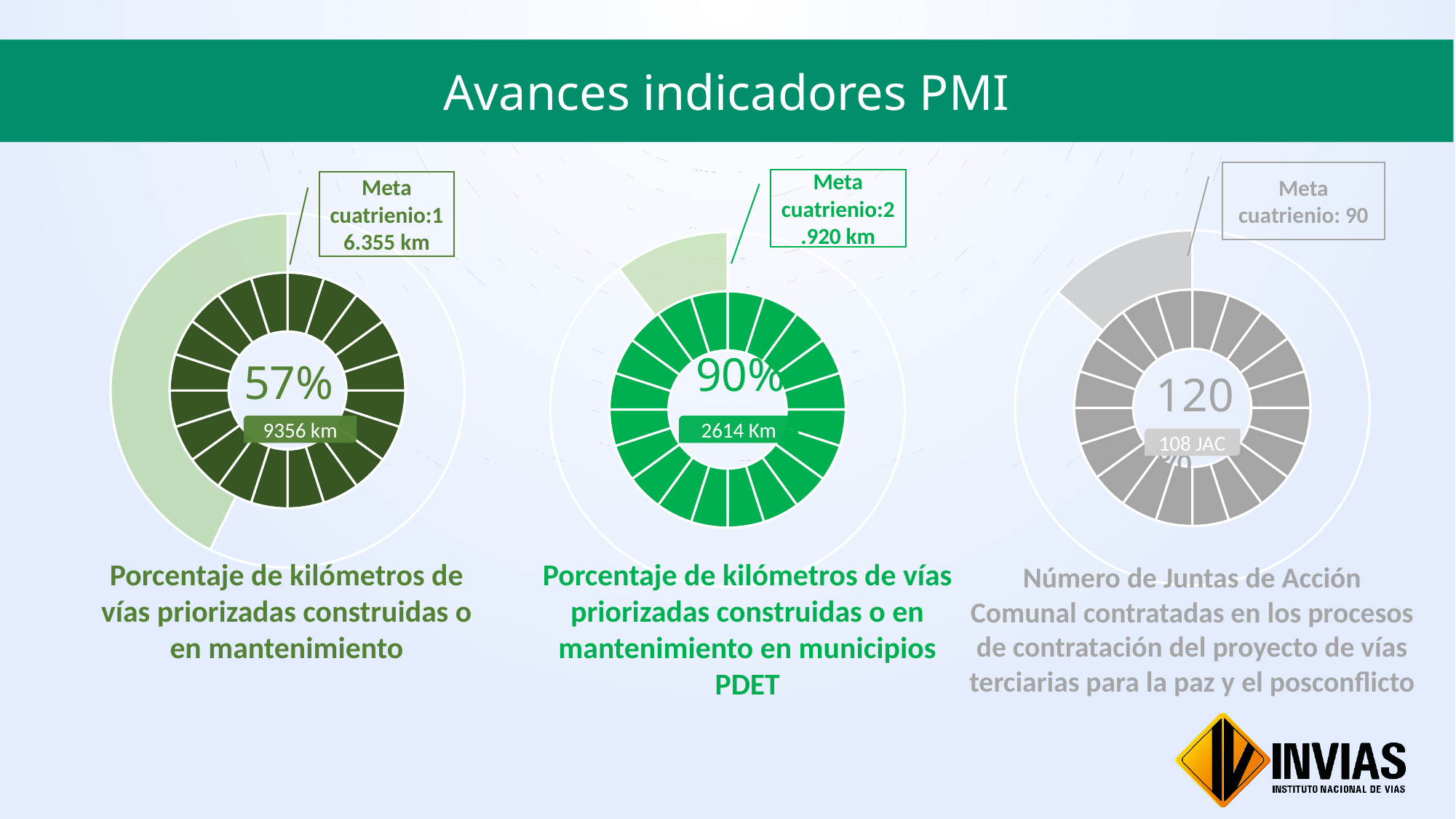
What is the title of the slide? Avances indicadores PMI How many gauge charts are shown on the slide? 3 On the right chart (Número de Juntas de Acción Comunal contratadas), what number is shown in the centre? 120 On the left chart, what is the 'Meta cuatrienio' value shown in the callout box? 16.355 km What is the difference between the percentage on the middle chart and the percentage on the left chart? 33% On the left chart (Porcentaje de kilómetros de vías priorizadas construidas o en mantenimiento), what percentage is shown in the centre? 57% On the right chart, what is the 'Meta cuatrienio' value shown in the callout box? 90 On the left chart, how many kilometres are shown below the percentage? 9356 km On the middle chart, how many kilometres are shown below the percentage? 2614 Km On the middle chart (municipios PDET), what percentage is shown in the centre? 90% Which chart shows the higher percentage of progress, the left chart or the middle chart? the middle chart On the middle chart, what is the 'Meta cuatrienio' value shown in the callout box? 2.920 km